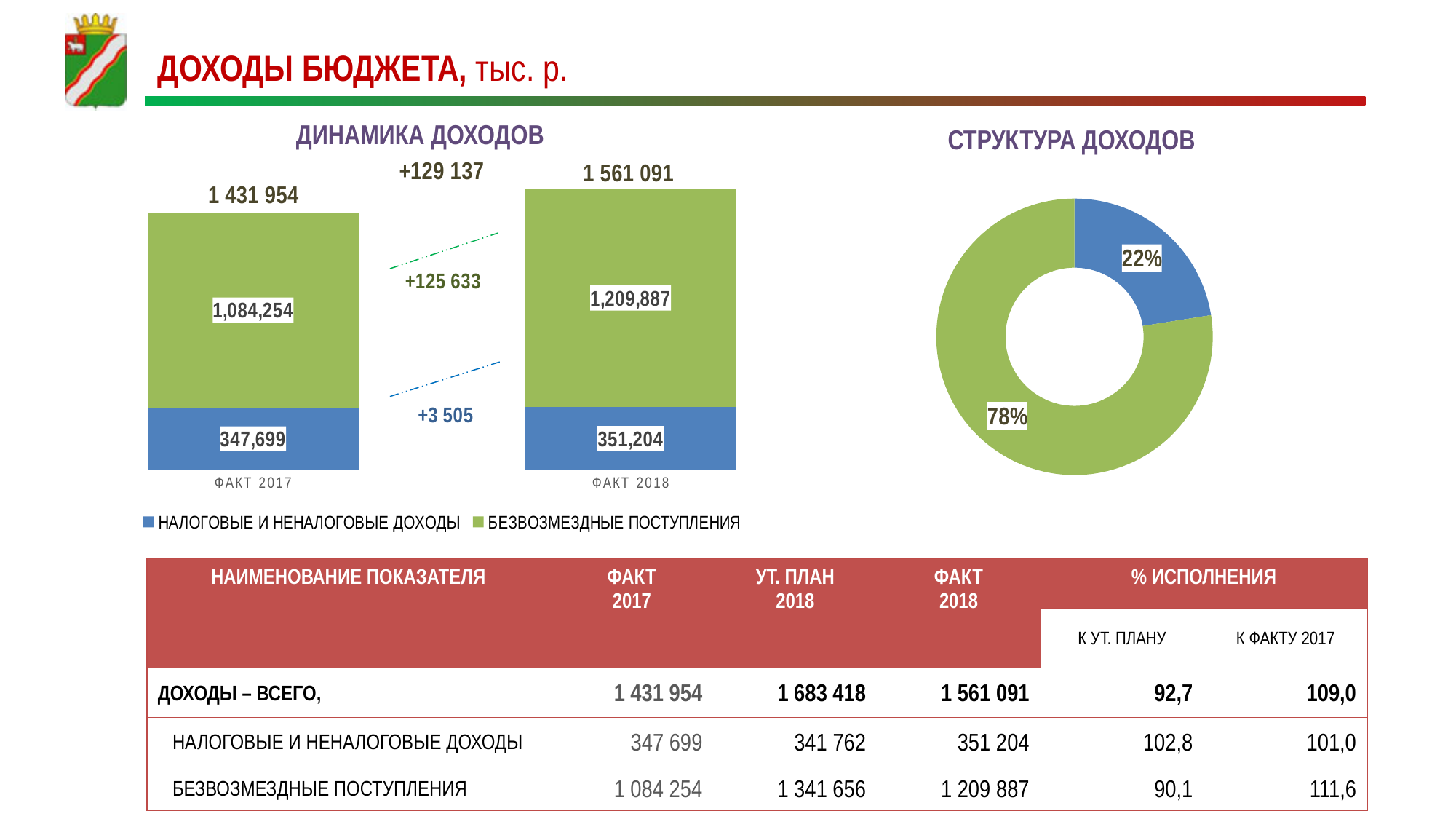
In the 'ДИНАМИКА ДОХОДОВ' chart, what is the total of the stacked bar for ФАКТ 2018? 1 561 091 In the 'ДИНАМИКА ДОХОДОВ' chart, which is larger: 'БЕЗВОЗМЕЗДНЫЕ ПОСТУПЛЕНИЯ' for ФАКТ 2017 or for ФАКТ 2018? ФАКТ 2018 In the 'ДИНАМИКА ДОХОДОВ' chart, how many series does the legend list? 2 In the 'СТРУКТУРА ДОХОДОВ' chart, what share does the blue slice ('НАЛОГОВЫЕ И НЕНАЛОГОВЫЕ ДОХОДЫ') have? 22% In the 'ДИНАМИКА ДОХОДОВ' chart, what is the value of 'НАЛОГОВЫЕ И НЕНАЛОГОВЫЕ ДОХОДЫ' for ФАКТ 2017? 347,699 In the 'СТРУКТУРА ДОХОДОВ' chart, which slice is the largest? БЕЗВОЗМЕЗДНЫЕ ПОСТУПЛЕНИЯ (78%) What kind of chart is 'ДИНАМИКА ДОХОДОВ'? Stacked bar chart In the 'ДИНАМИКА ДОХОДОВ' chart, what is the difference between the 'БЕЗВОЗМЕЗДНЫЕ ПОСТУПЛЕНИЯ' values for ФАКТ 2018 and ФАКТ 2017? 125 633 In the 'ДИНАМИКА ДОХОДОВ' chart, what is the value of 'БЕЗВОЗМЕЗДНЫЕ ПОСТУПЛЕНИЯ' for ФАКТ 2018? 1,209,887 In the 'ДИНАМИКА ДОХОДОВ' chart, what is the difference between the 'НАЛОГОВЫЕ И НЕНАЛОГОВЫЕ ДОХОДЫ' values for ФАКТ 2018 and ФАКТ 2017? 3 505 In the 'ДИНАМИКА ДОХОДОВ' chart, how many categories are shown on the x axis? 2 In the 'ДИНАМИКА ДОХОДОВ' chart, what is the total of the stacked bar for ФАКТ 2017? 1 431 954